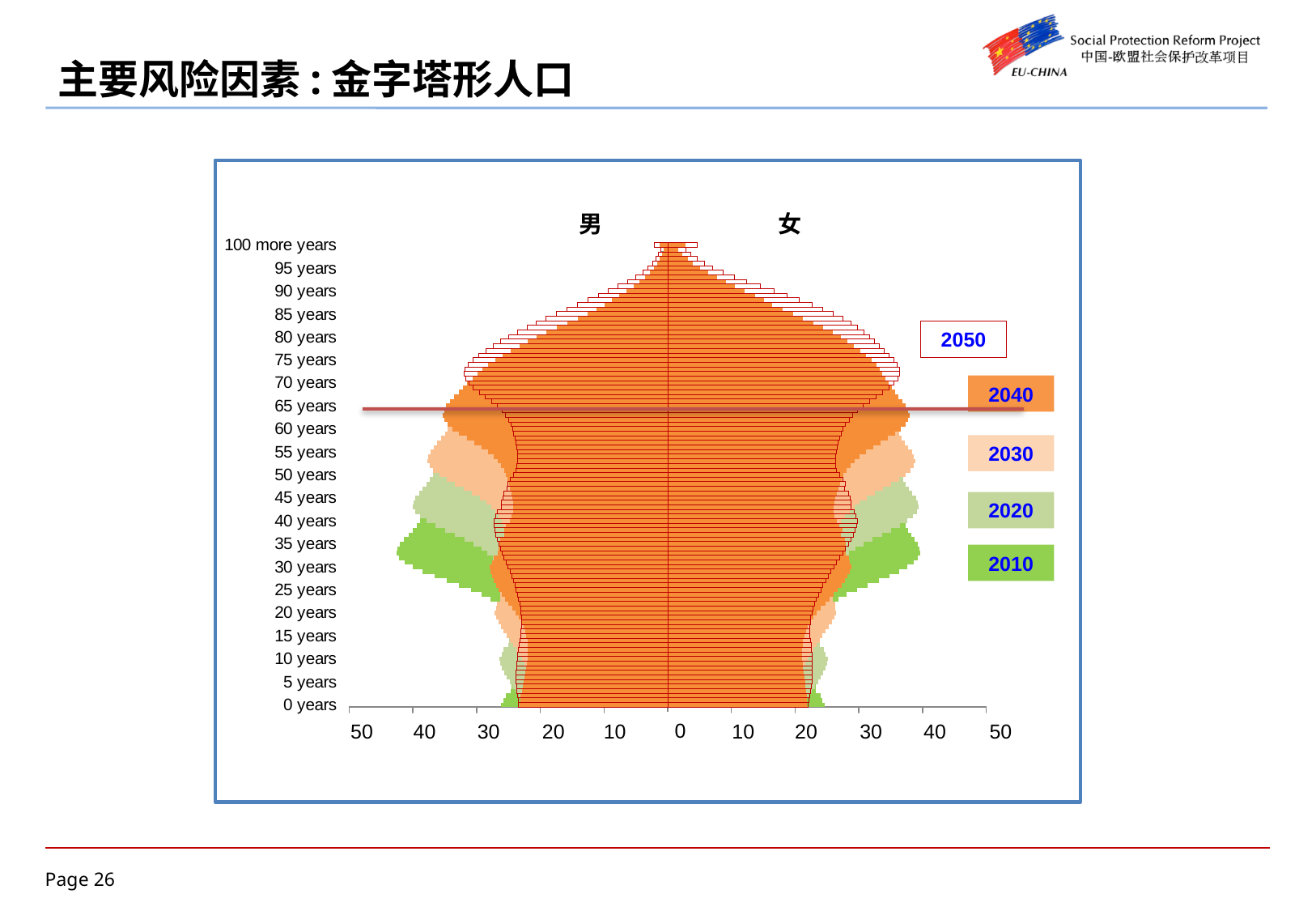
What kind of chart is shown on the slide? bar chart Is the 2010 value for males aged 0 years greater or less than 30? less At which age group is the horizontal red line drawn across the chart? 65 years Which colour represents 2010 in the legend? green Is the 2040 value for females aged 95 years greater or less than 10? less Is the 2010 value for males aged 35 years greater or less than 40? greater How many age-group categories are labelled on the vertical axis? 21 How many years does the legend list? 5 Which years are listed in the legend? 2010, 2020, 2030, 2040, 2050